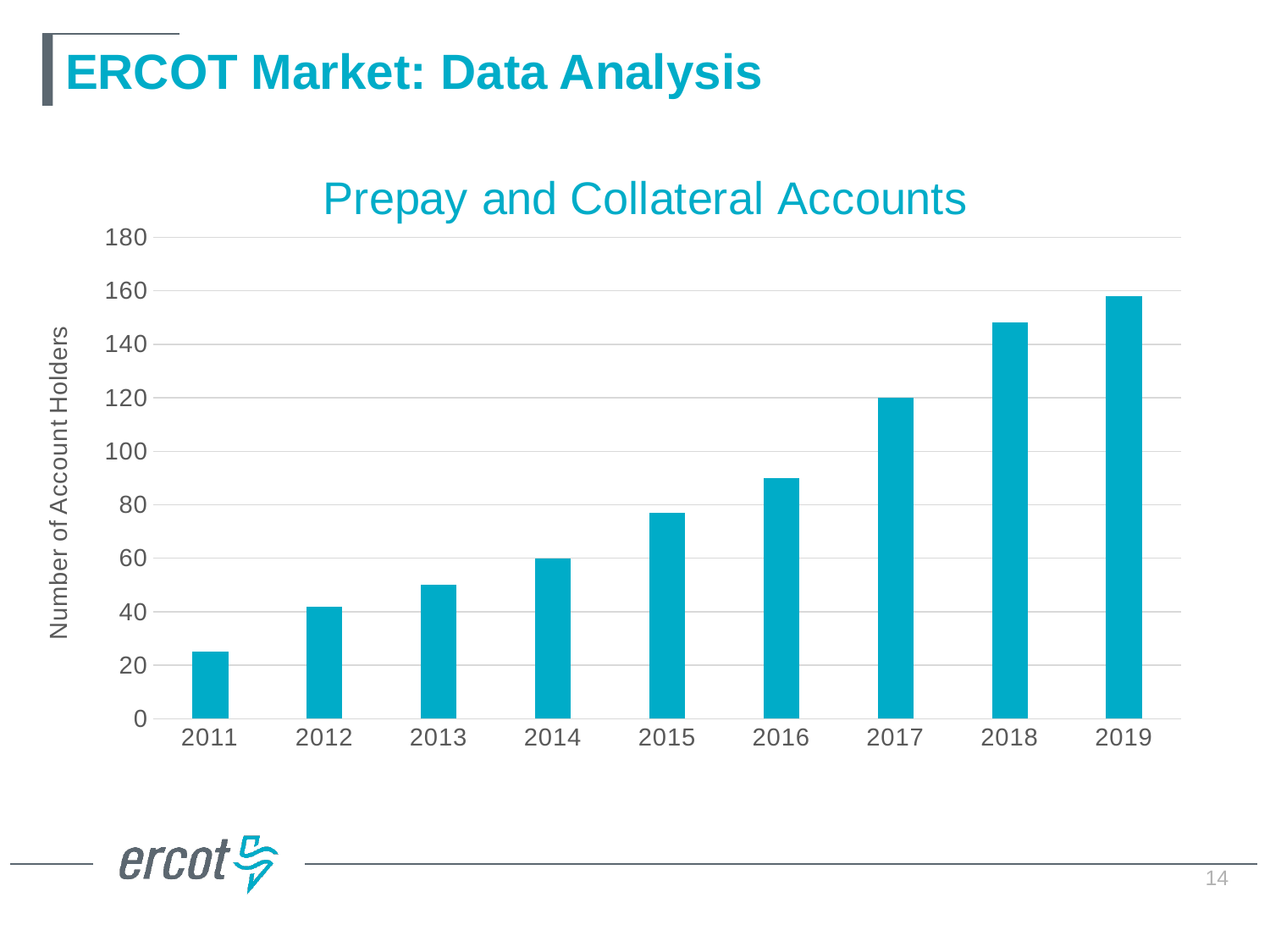
How many years are shown on the x axis of the chart? 9 Which year has the highest number of account holders? 2019 Is the value for 2015 greater or less than 80? less Is the value for 2011 greater or less than 40? less Is the value for 2016 greater or less than 100? less Do the values rise or fall from 2011 to 2019? Rise What is the label on the vertical axis of the chart? Number of Account Holders Which year has more account holders, 2016 or 2018? 2018 What type of chart is shown on the slide? Bar chart Which year has the lowest number of account holders? 2011 What is the title of the chart? Prepay and Collateral Accounts